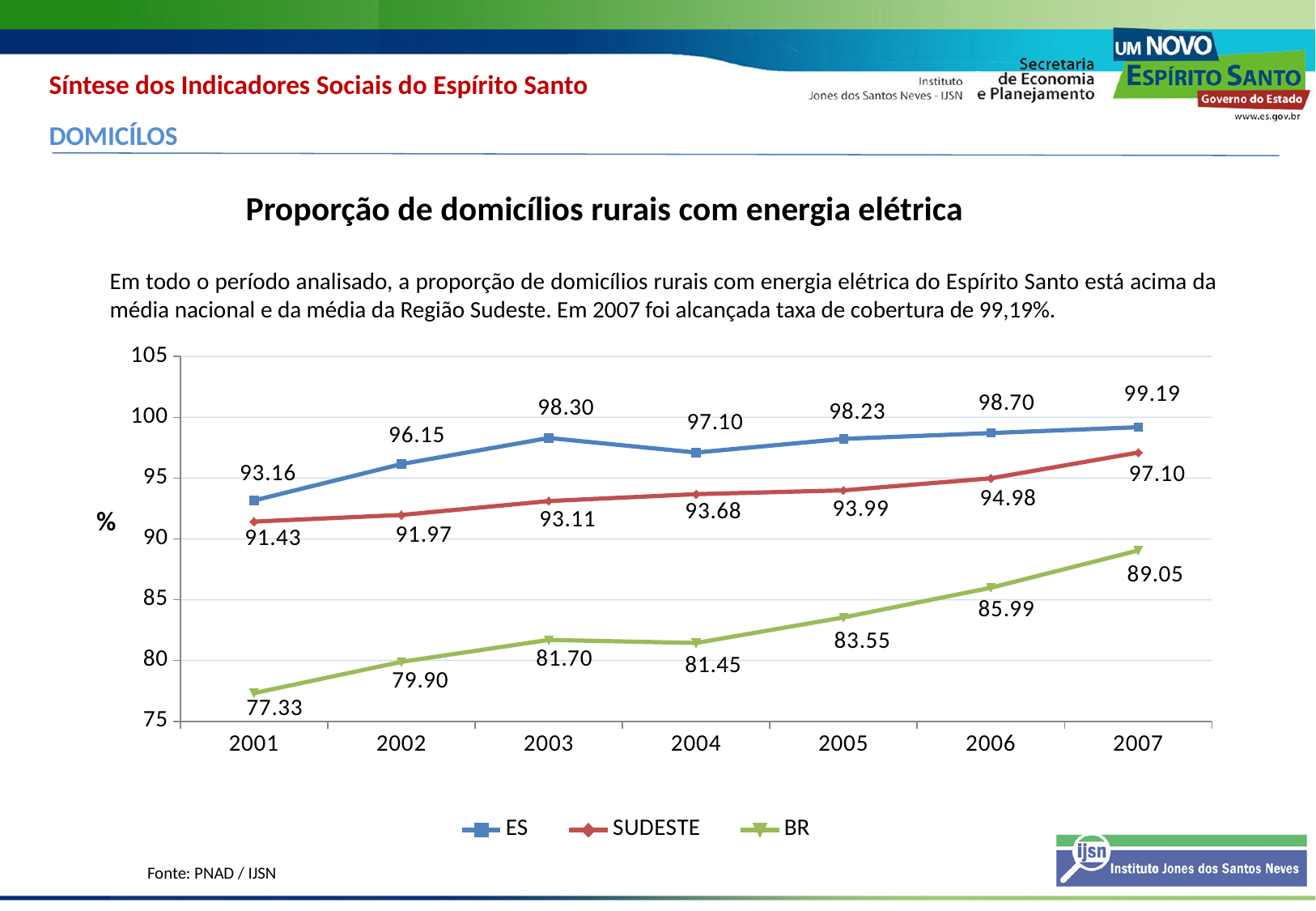
Is the value for BR in 2005 greater or less than 85? less What is the value for ES in 2007? 99.19 Which is larger in 2003: ES or SUDESTE? ES What is the difference between ES and BR in 2007? 10.14 What kind of chart is this? line chart In which year is the BR series at its highest? 2007 In which year is the ES series at its lowest? 2001 Does the SUDESTE series rise or fall from 2001 to 2007? rise How many series does the legend list? 3 How many years are shown on the x axis? 7 What is the value for BR in 2001? 77.33 What is the value for SUDESTE in 2004? 93.68